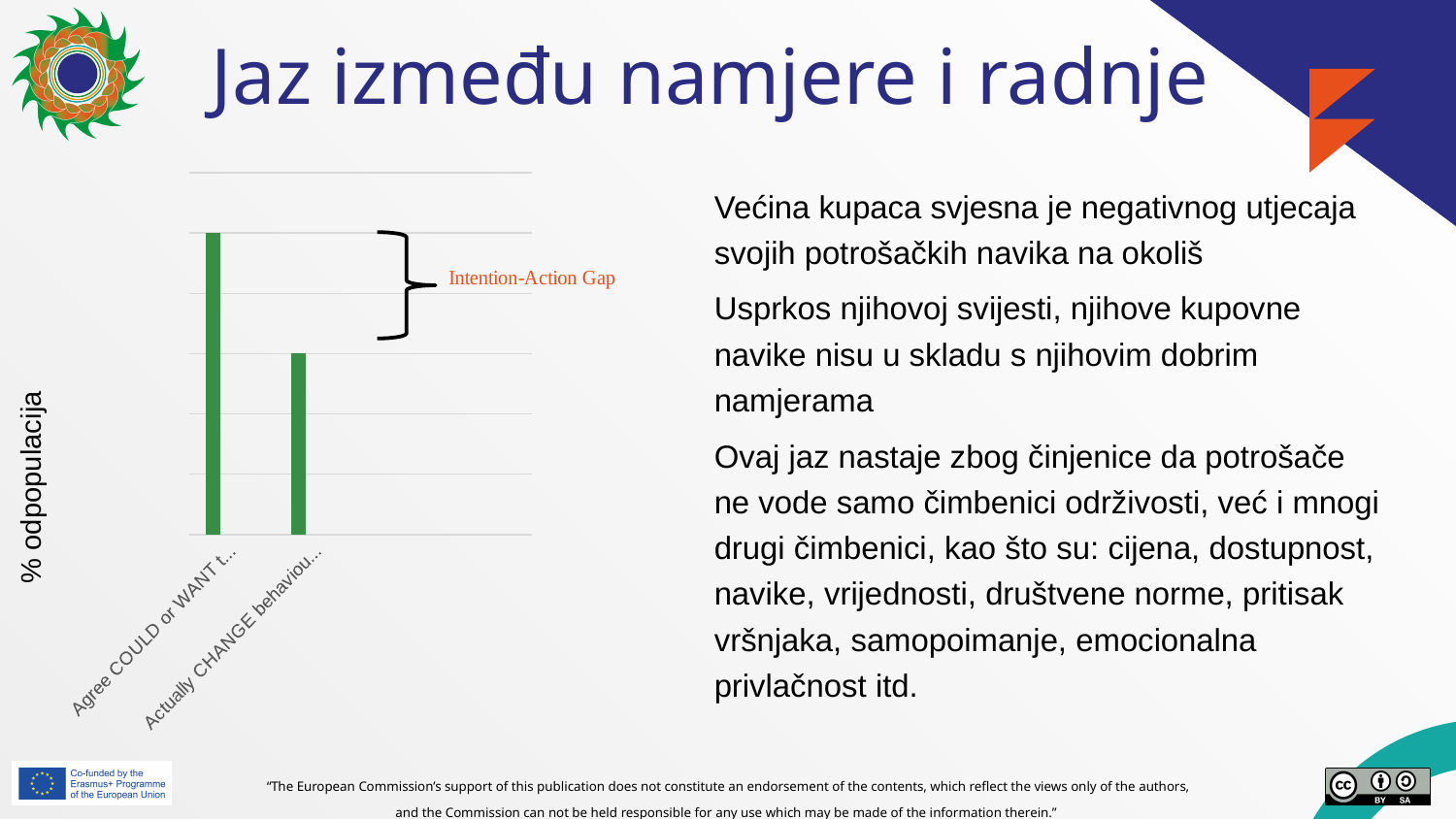
What is the label on the vertical axis of the chart? % odpopulacija What kind of chart is shown on the slide? bar chart What text does the bracket annotation next to the chart read? Intention-Action Gap Which category has the shortest bar in the chart? Actually CHANGE behaviou... How many bars are plotted in the chart? 2 Do the bar values rise or fall from left to right along the x axis? fall Which category has the tallest bar in the chart? Agree COULD or WANT t... Which bar is taller: "Agree COULD or WANT t..." or "Actually CHANGE behaviou..."? Agree COULD or WANT t...